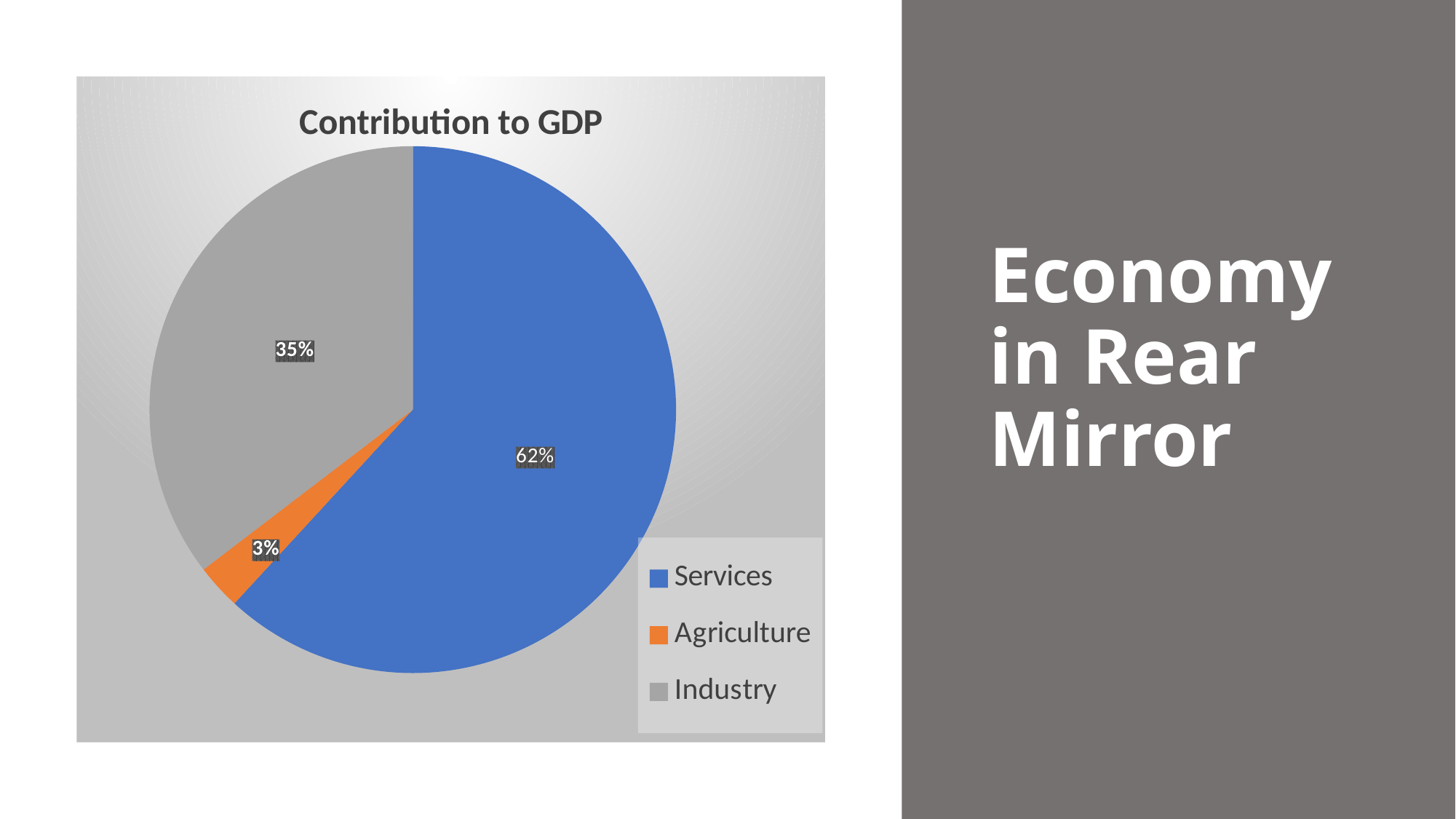
Which sector contributes the smallest share of GDP? Agriculture What is the title of the chart? Contribution to GDP What kind of chart is shown on the slide? pie chart What colour is the Agriculture slice? orange How many sectors are shown in the pie chart? 3 Which contributes more to GDP, Industry or Agriculture? Industry Which sector contributes the largest share of GDP? Services What share of GDP does Agriculture contribute? 3% What is the difference in percentage points between the Services and Industry shares? 27 What share of GDP does Industry contribute? 35% What is the difference in percentage points between the Industry and Agriculture shares? 32 What share of GDP does Services contribute? 62%